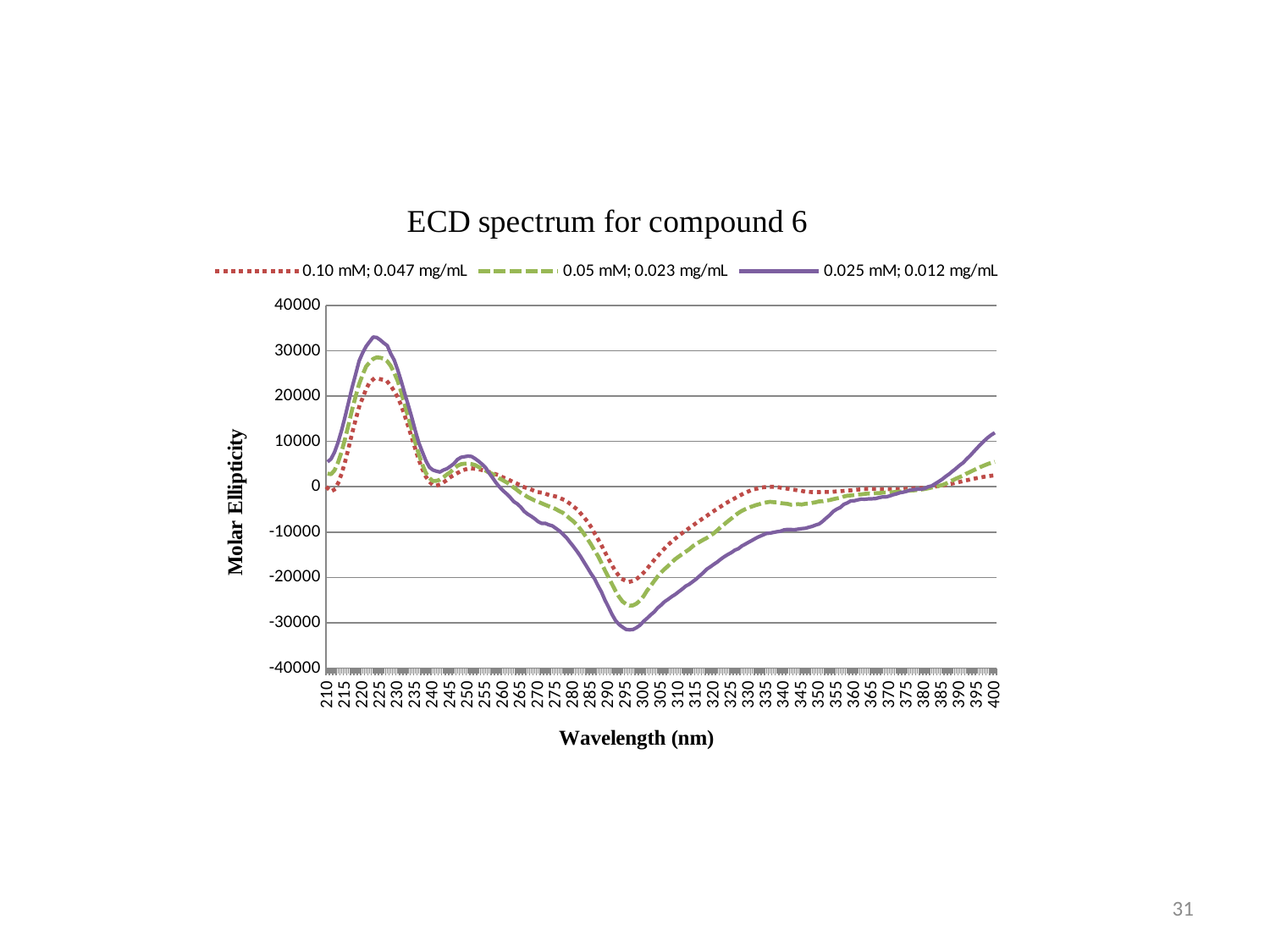
How many series does the legend list? 3 What is the label of the y axis? Molar Ellipticity What is the title of the chart? ECD spectrum for compound 6 Which series has the lowest value at 295 nm? 0.025 mM; 0.012 mg/mL Between 225 nm and 295 nm, do the values of the 0.025 mM; 0.012 mg/mL series rise or fall? fall Is the value for the 0.025 mM; 0.012 mg/mL series at 295 nm greater or less than -30000? less What kind of chart is shown on the slide? line chart Is the value for the 0.10 mM; 0.047 mg/mL series at 225 nm greater or less than 30000? less Is the value for the 0.025 mM; 0.012 mg/mL series at 225 nm greater or less than 30000? greater Which series has the highest value at 225 nm? 0.025 mM; 0.012 mg/mL At 400 nm, which series has the larger value: 0.025 mM; 0.012 mg/mL or 0.10 mM; 0.047 mg/mL? 0.025 mM; 0.012 mg/mL